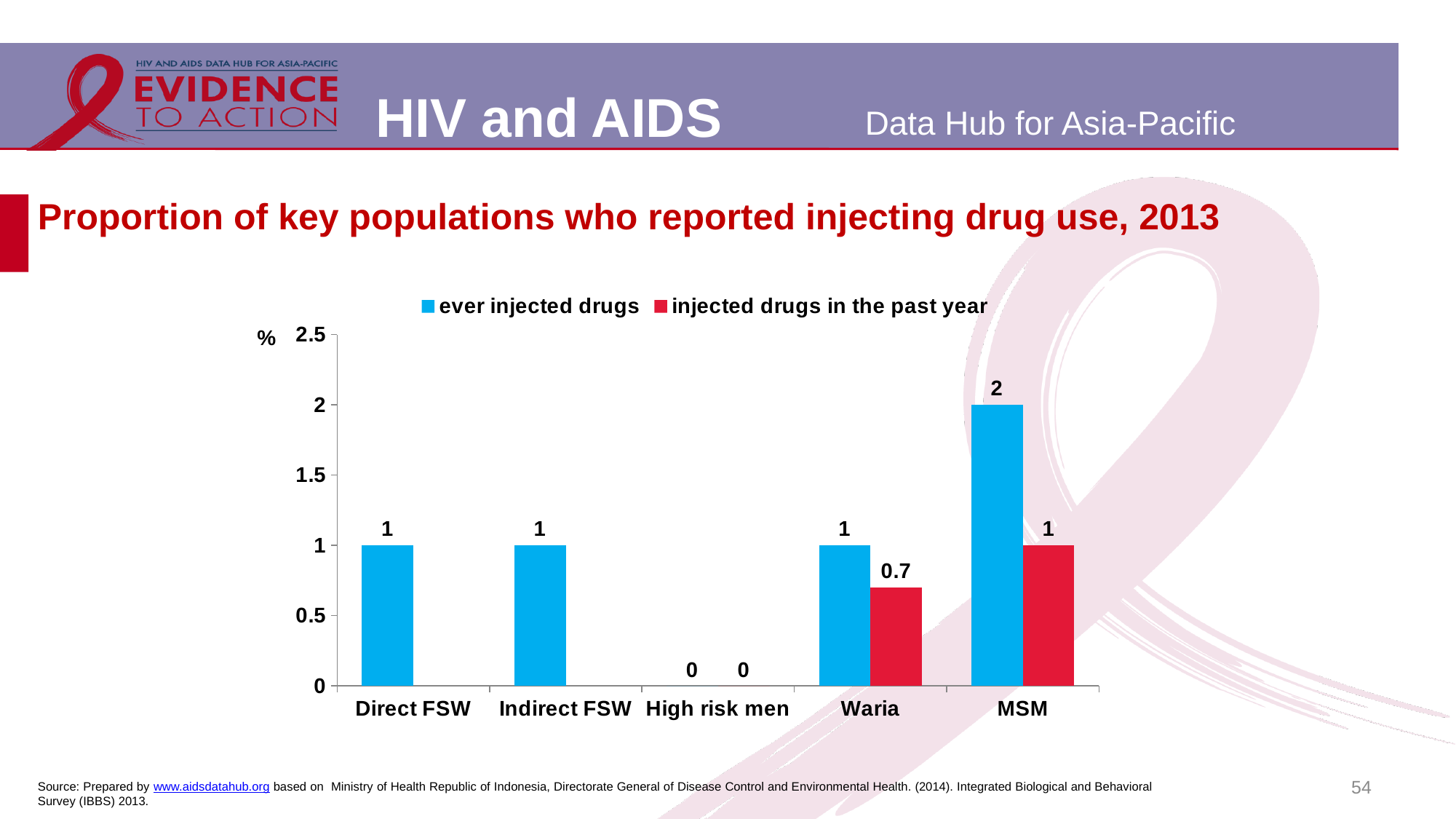
What is the difference between the 'ever injected drugs' and 'injected drugs in the past year' values for MSM? 1 What is the value for High risk men in the 'ever injected drugs' series? 0 What is the value for Direct FSW in the 'ever injected drugs' series? 1 How many series does the legend list? 2 Which key population has the lowest value for 'ever injected drugs'? High risk men What is the value for Waria in the 'injected drugs in the past year' series? 0.7 What kind of chart is shown on the slide? bar chart Which key population has the highest value for 'ever injected drugs'? MSM What is the value for MSM in the 'ever injected drugs' series? 2 How many key population categories are shown on the x axis? 5 For Waria, which is larger: 'ever injected drugs' or 'injected drugs in the past year'? ever injected drugs Is the 'ever injected drugs' value for MSM greater or less than 1.5? greater